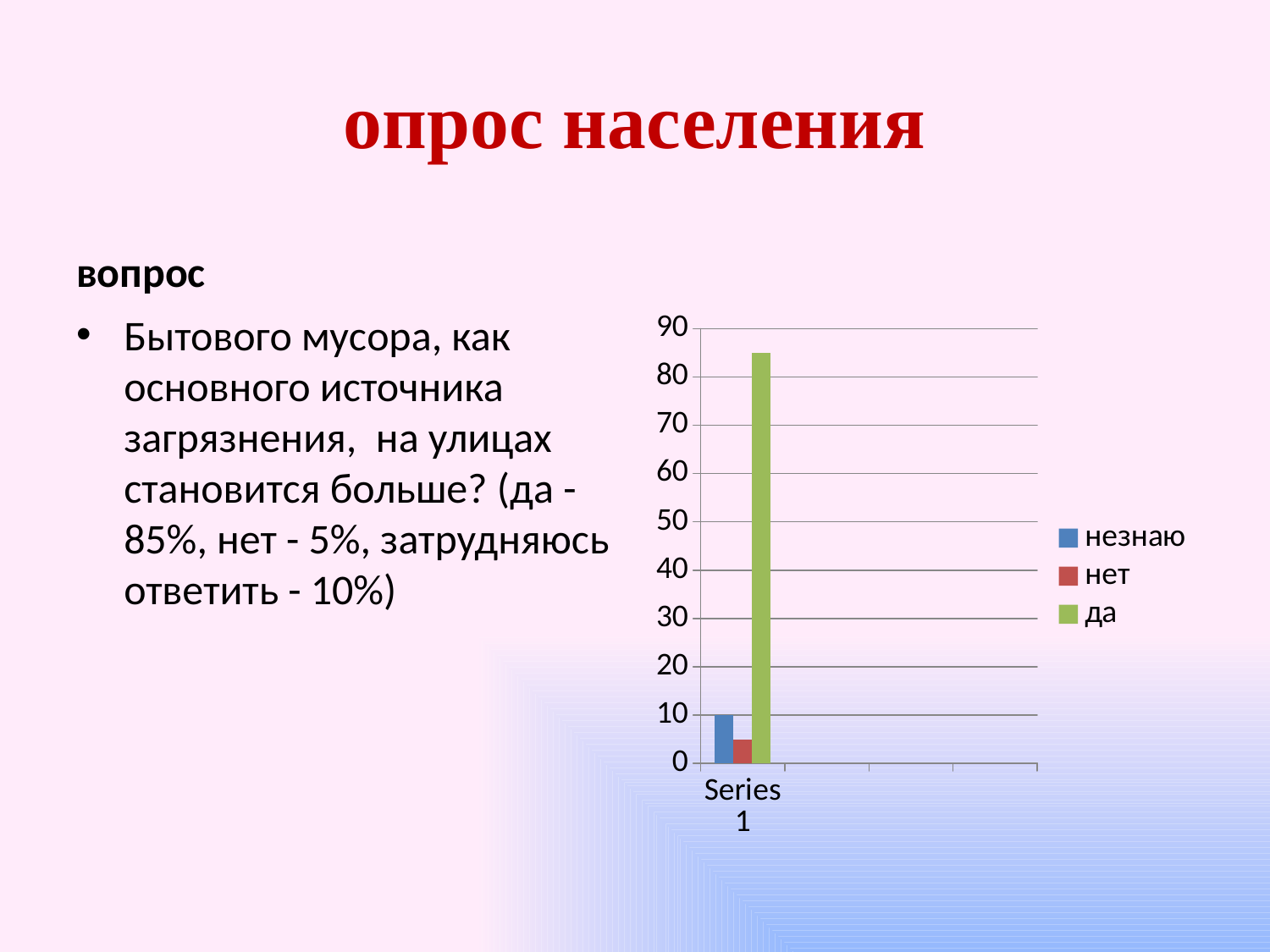
Is the value for да greater or less than 80? greater Is the value for нет greater or less than 10? less Which series has the lowest bar in the chart? нет Which is larger in the chart, the bar for да or the bar for незнаю? да Which is larger in the chart, the bar for незнаю or the bar for нет? незнаю What kind of chart is shown on the slide? bar chart What is the value of the bar for незнаю? 10 How many categories are shown on the x axis of the chart? 1 How many series does the chart legend list? 3 Which series has the highest bar in the chart? да What is the title of the slide containing the chart? опрос населения What colour is the bar for да in the chart? green